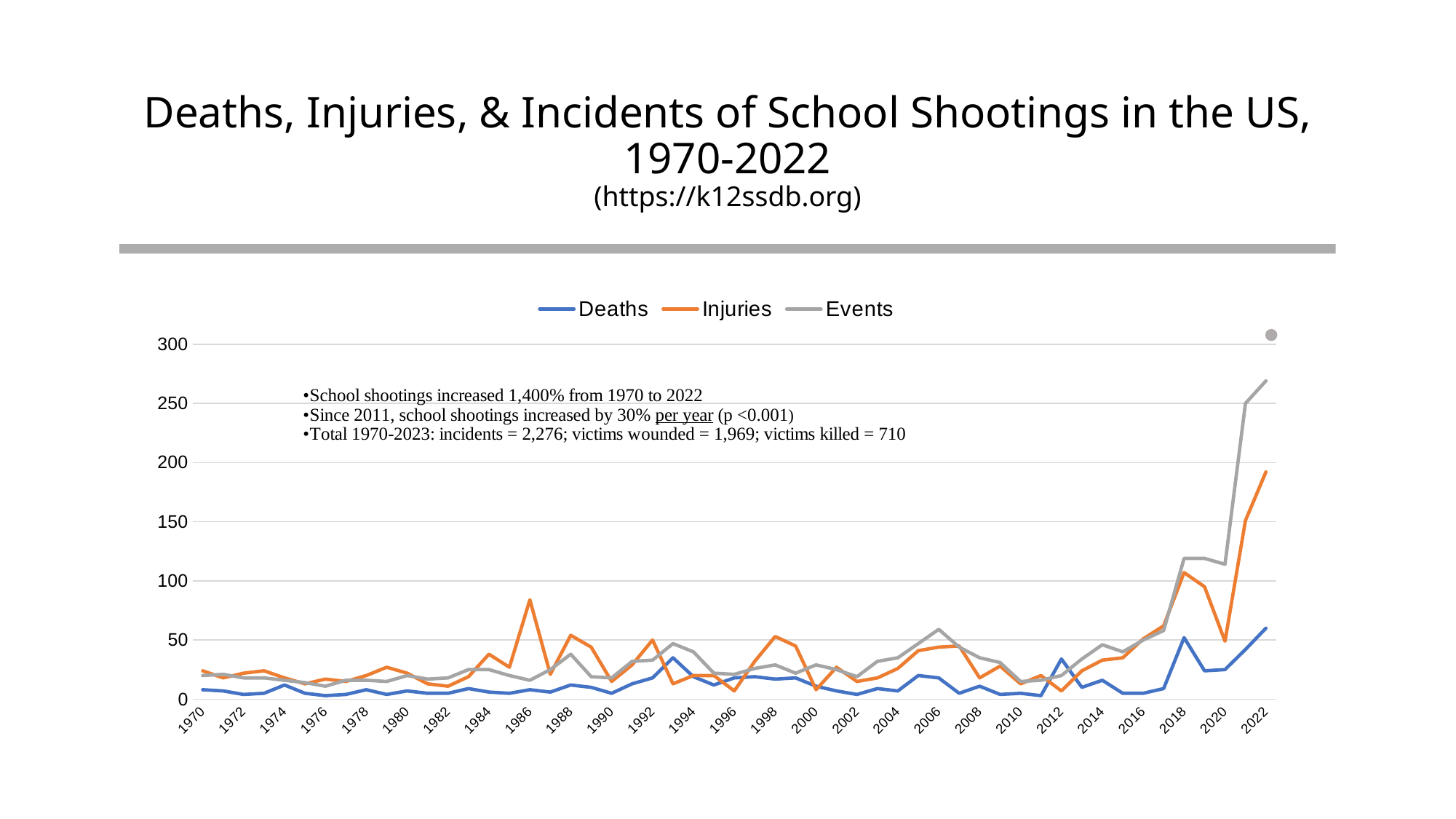
Is the value for Injuries in 1986 greater or less than 50? greater In which year does the Events series reach its highest value? 2022 In 1986, which is larger: Injuries or Events? Injuries In 2022, which is larger: Events or Injuries? Events Do the Events values rise or fall from 2012 to 2022? rise Is the value for Injuries in 2022 greater or less than 150? greater What are the three series named in the legend? Deaths, Injuries, Events Is the value for Events in 2018 greater or less than 100? greater How many series does the legend list? 3 Which series reaches the highest value on the chart? Events What kind of chart is shown on the slide? line chart